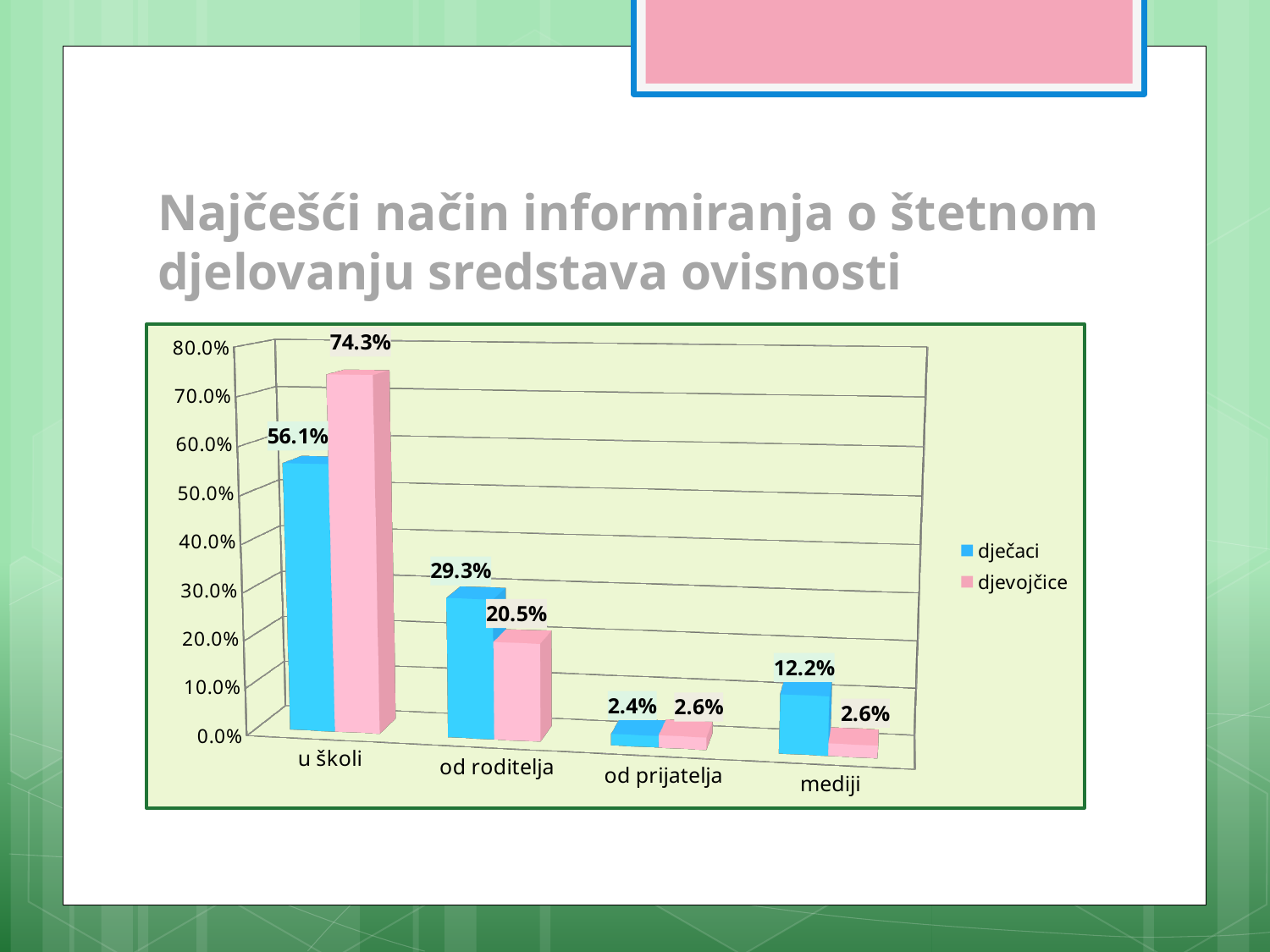
In the od roditelja category, which series has the larger value, dječaci or djevojčice? dječaci What is the value for dječaci in the u školi category? 56.1% Which category has the highest value for djevojčice? u školi What is the value for dječaci in the mediji category? 12.2% What is the difference between the djevojčice and dječaci values in the u školi category? 18.2% Which category has the lowest value for dječaci? od prijatelja What kind of chart is shown on the slide? bar chart What colour represents the djevojčice series? pink What is the value for djevojčice in the od roditelja category? 20.5% How many series does the legend list? 2 How many categories are shown on the x axis? 4 Is the value for dječaci in the od roditelja category greater or less than 20.0%? greater